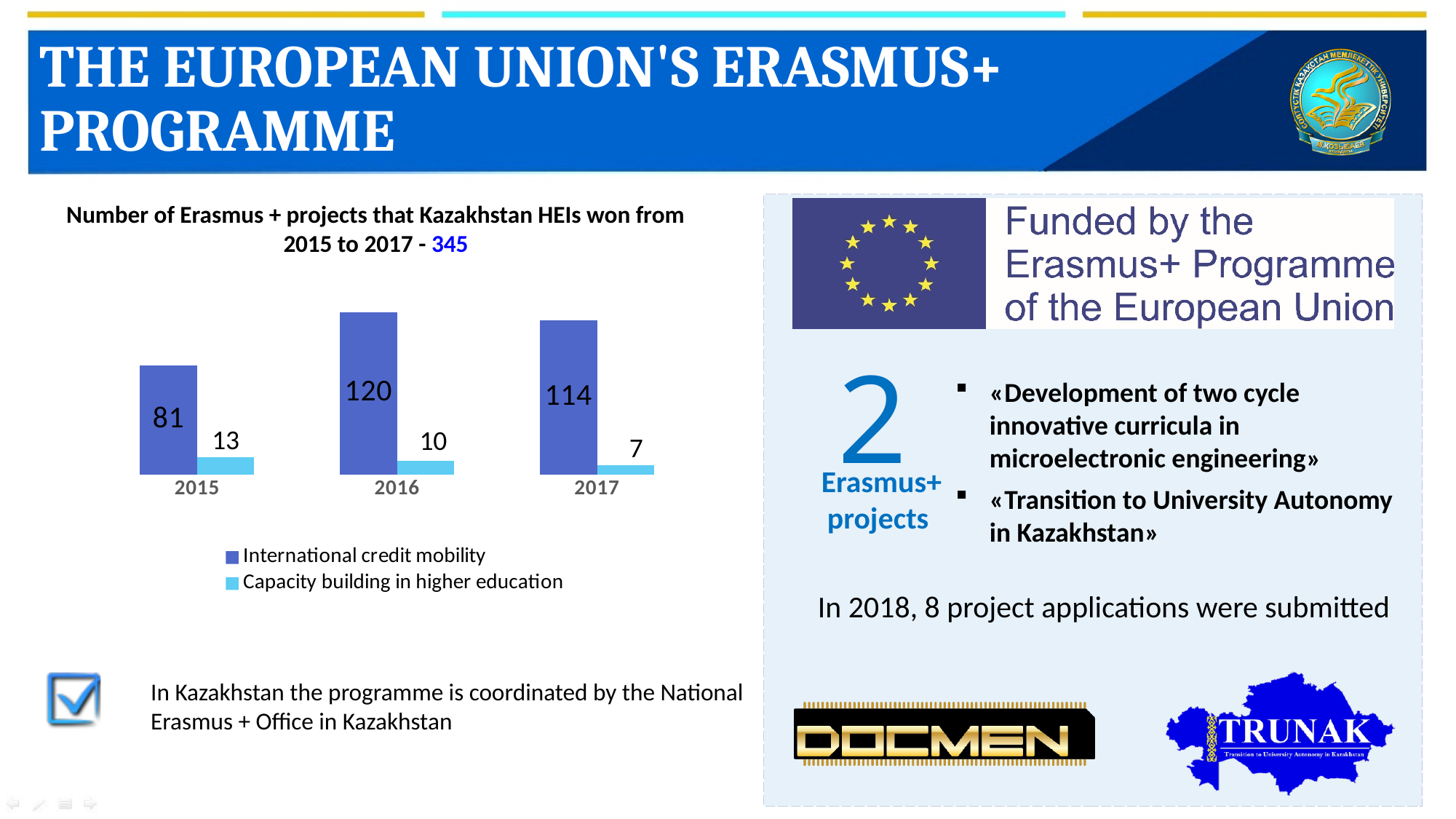
Does the value for Capacity building in higher education rise or fall from 2015 to 2017? Fall How many series does the chart legend list? 2 What is the difference between International credit mobility in 2016 and 2017? 6 Which year has the lowest value for Capacity building in higher education? 2017 What is the value for International credit mobility in 2016? 120 What kind of chart is shown on the slide? Bar chart Which is larger: Capacity building in higher education in 2015 or in 2016? 2015 Which year has the highest value for International credit mobility? 2016 How many years are shown on the x axis of the chart? 3 What is the value for Capacity building in higher education in 2017? 7 What total number of projects is stated in the chart title? 345 What is the value for International credit mobility in 2015? 81